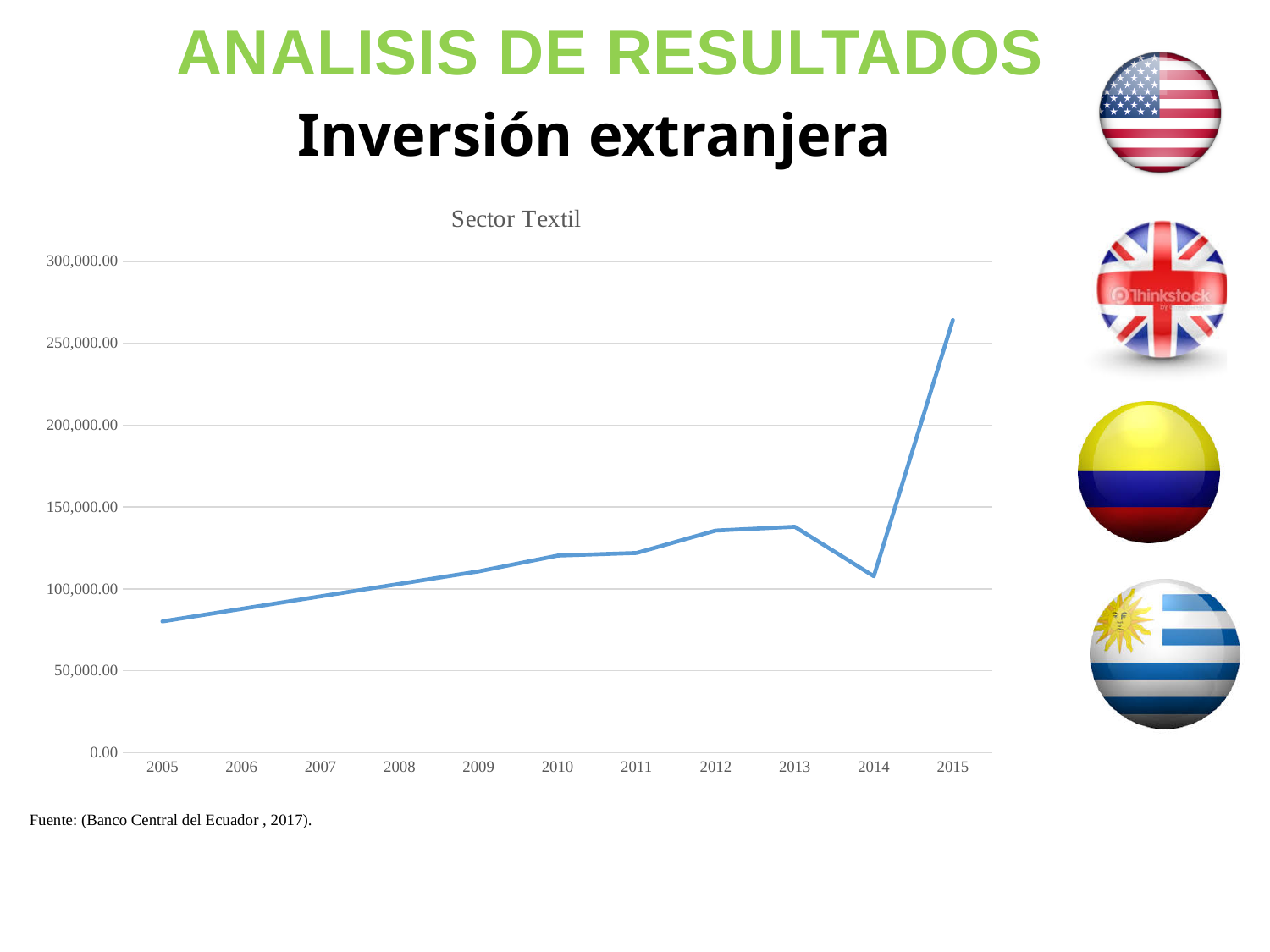
What source is cited below the chart? Banco Central del Ecuador, 2017 Is the value for 2015 greater or less than 250,000.00? greater Do the values rise or fall from 2005 to 2013? rise Is the value for 2005 greater or less than 100,000.00? less Which year has the lowest value in the chart? 2005 Is the value for 2010 greater or less than 100,000.00? greater Which year has the larger value, 2013 or 2014? 2013 What is the title of the chart? Sector Textil What kind of chart is shown on the slide? line chart Which year has the highest value in the chart? 2015 How many years are plotted along the x axis of the chart? 11